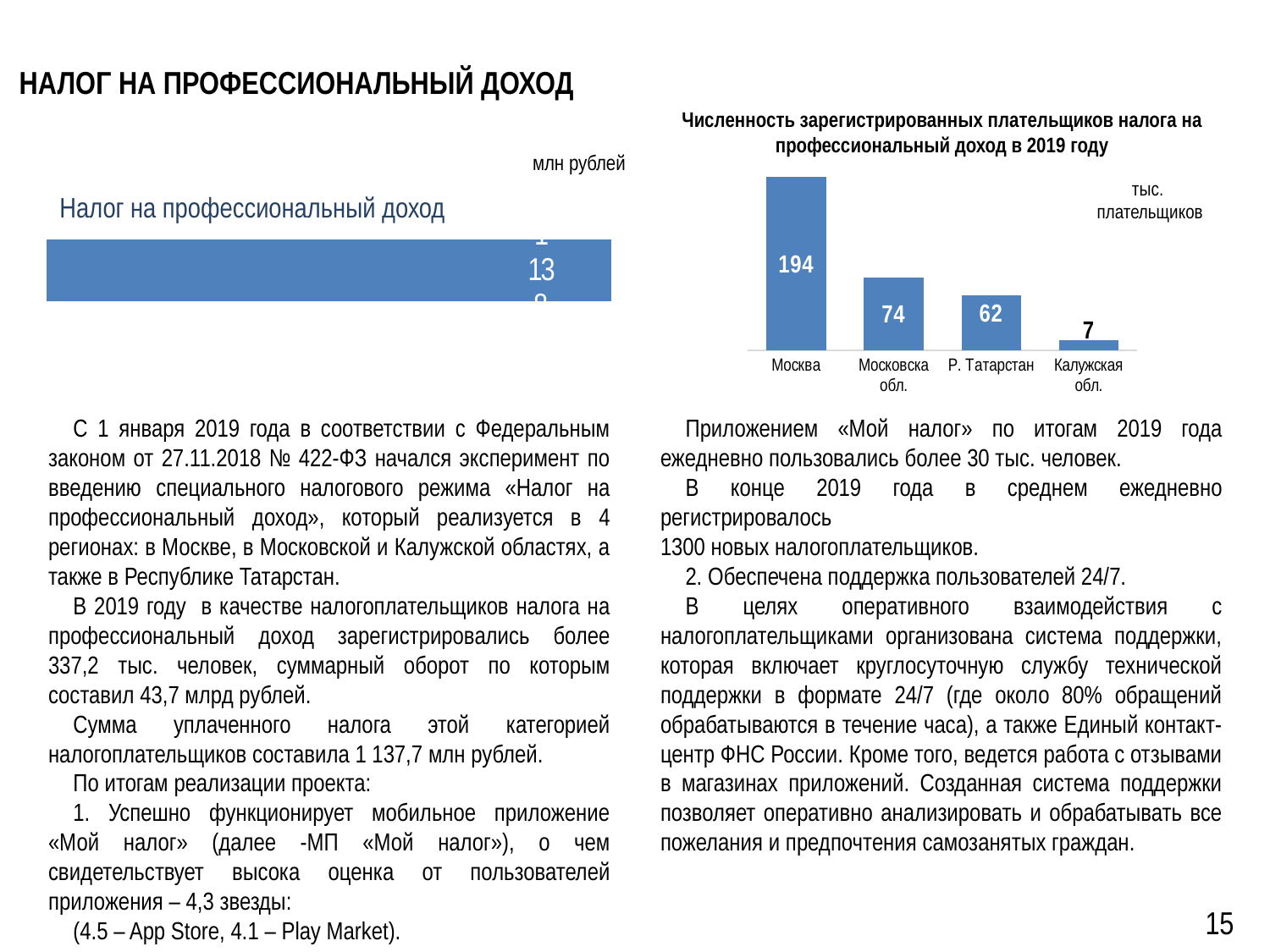
What kind of chart is the chart on the right side of the slide? bar chart On the chart titled «Численность зарегистрированных плательщиков налога на профессиональный доход в 2019 году», what is the value for Москва? 194 What unit is indicated for the chart on the left side of the slide titled «Налог на профессиональный доход»? млн рублей On the chart titled «Численность зарегистрированных плательщиков налога на профессиональный доход в 2019 году», do the values rise or fall from left to right? fall On the chart titled «Численность зарегистрированных плательщиков налога на профессиональный доход в 2019 году», how many regions are shown? 4 On the chart titled «Численность зарегистрированных плательщиков налога на профессиональный доход в 2019 году», what is the difference between the values for Москва and Московская обл.? 120 On the chart titled «Численность зарегистрированных плательщиков налога на профессиональный доход в 2019 году», which is larger, the value for Московская обл. or the value for Р. Татарстан? Московская обл. On the chart titled «Численность зарегистрированных плательщиков налога на профессиональный доход в 2019 году», what is the value for Р. Татарстан? 62 On the chart titled «Численность зарегистрированных плательщиков налога на профессиональный доход в 2019 году», which region has the lowest value? Калужская обл. On the chart titled «Численность зарегистрированных плательщиков налога на профессиональный доход в 2019 году», which region has the highest value? Москва On the chart titled «Численность зарегистрированных плательщиков налога на профессиональный доход в 2019 году», what is the value for Московская обл.? 74 On the chart titled «Численность зарегистрированных плательщиков налога на профессиональный доход в 2019 году», what is the value for Калужская обл.? 7